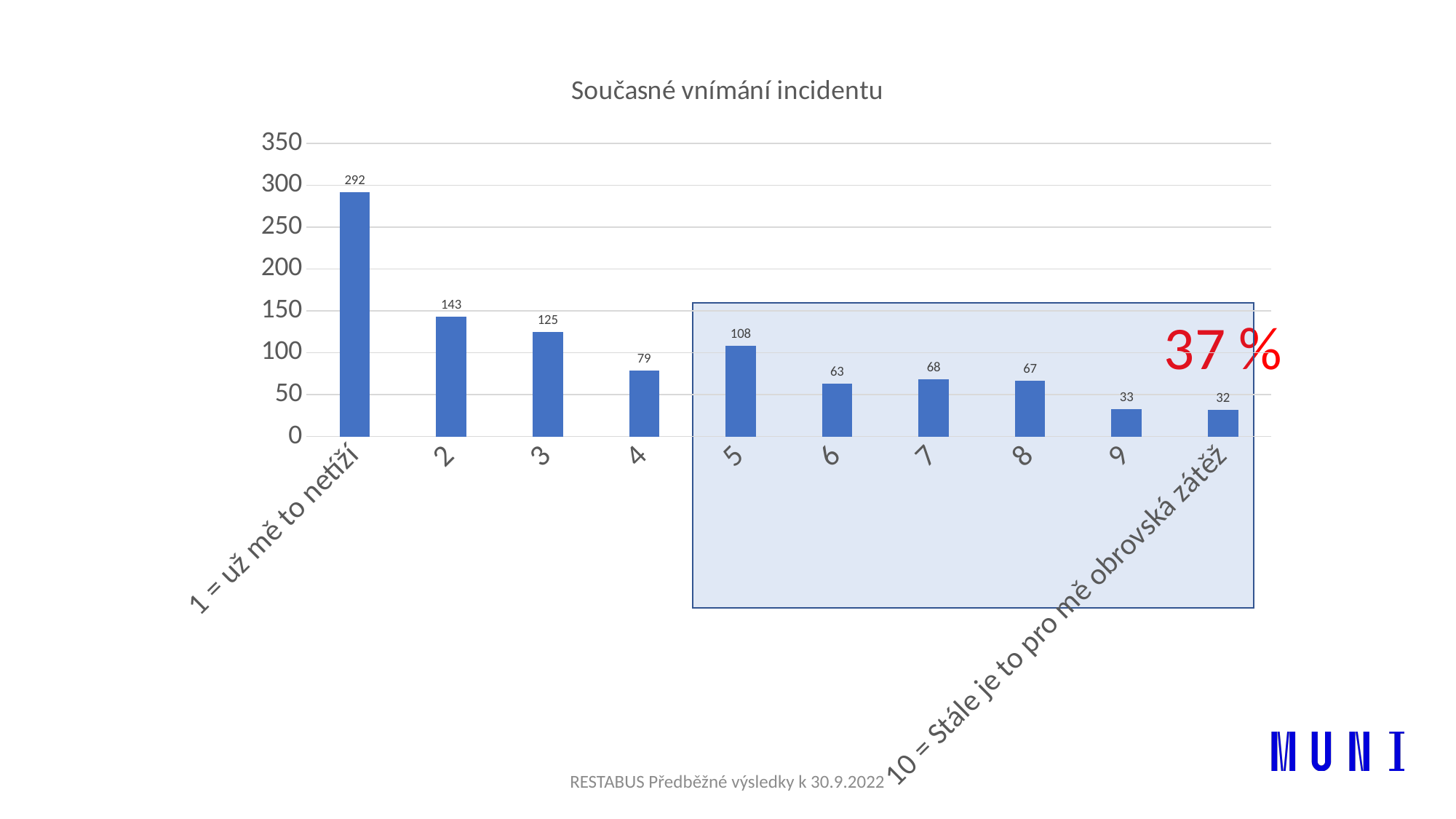
What is the difference between the values for category 1 and category 2? 149 What is the title of the chart? Současné vnímání incidentu Is the value for category 4 greater or less than 100? less What is the value for category 5? 108 Which category has the highest value? 1 = už mě to netíží Which category has the lowest value? 10 = Stále je to pro mě obrovská zátěž What is the value for category 2? 143 What is the value for the category '10 = Stále je to pro mě obrovská zátěž'? 32 What kind of chart is shown? bar chart Which is larger, the value for category 7 or category 8? 7 How many categories are shown on the x axis? 10 Do the values generally rise or fall from category 1 to category 10? fall